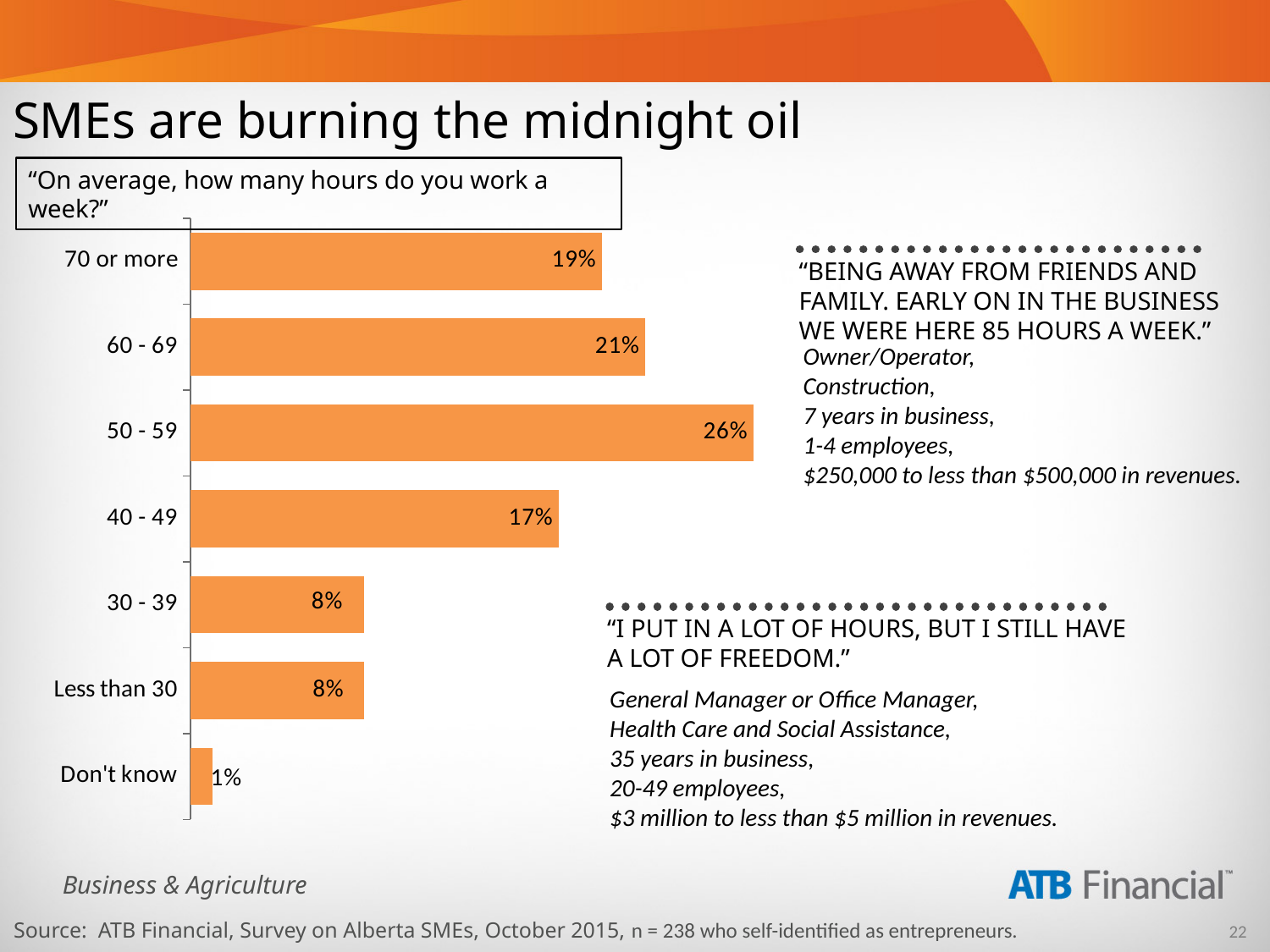
Which category has the lowest percentage? Don't know What kind of chart is shown on the slide? Bar chart What is the difference in percentage points between the 60 - 69 and 40 - 49 categories? 4 Which is larger, the percentage for 70 or more hours or the percentage for 60 - 69 hours? 60 - 69 What percentage of respondents answered 'Don't know'? 1% What is the combined percentage of respondents who work 60 - 69 hours or 70 or more hours a week? 40% Which category has the highest percentage? 50 - 59 What colour are the bars in the chart? Orange How many categories are shown in the chart? 7 What survey question does the chart present? "On average, how many hours do you work a week?" What percentage of respondents work 50 - 59 hours a week? 26% What percentage of respondents work 70 or more hours a week? 19%